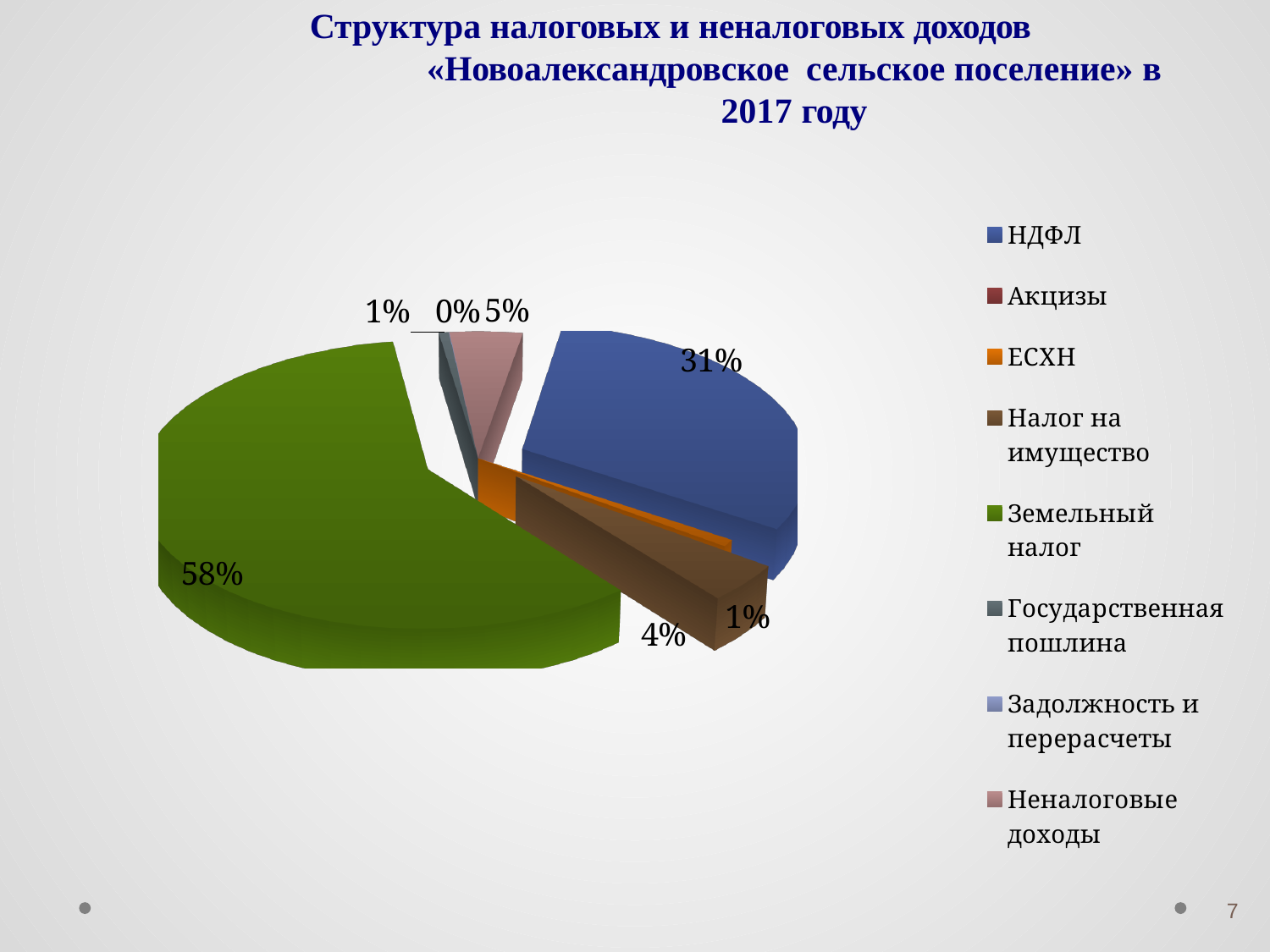
What percentage is shown for Неналоговые доходы? 5% Which category has the largest slice of the pie? Земельный налог What is the value for Налог на имущество? 4% Which year does the chart title refer to? 2017 What type of chart is shown on the slide? Pie chart What share of the pie does Земельный налог account for? 58% How many entries does the legend list? 8 What is the value shown for НДФЛ? 31% Which is larger, НДФЛ or Налог на имущество? НДФЛ Which is larger, Неналоговые доходы or Налог на имущество? Неналоговые доходы What is the difference between the shares of Земельный налог and НДФЛ? 27% What colour is the slice for Земельный налог? Green